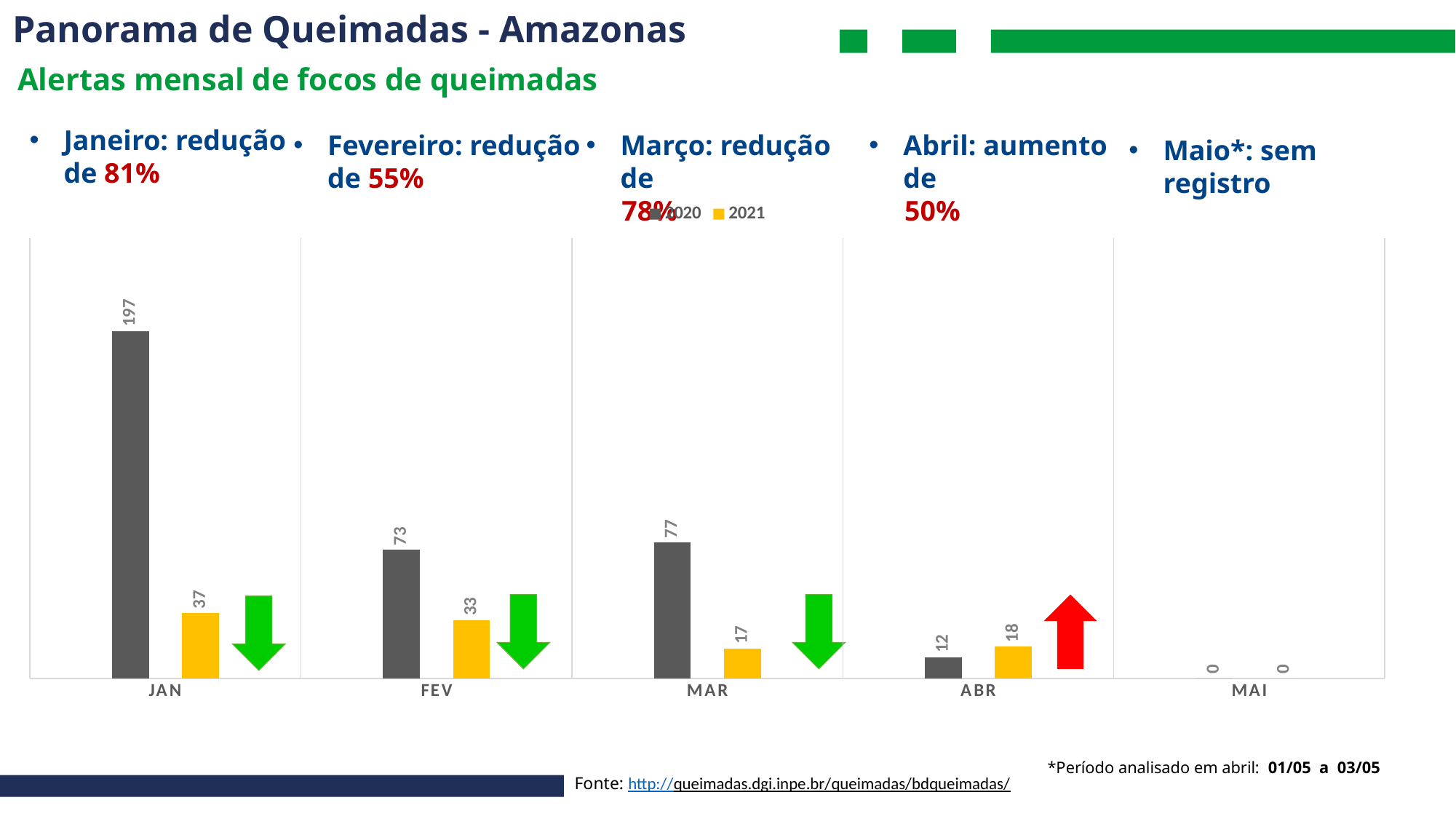
How many series does the legend list? 2 What kind of chart is shown on the slide? Bar chart What is the value for 2020 in ABR? 12 What is the value for 2020 in JAN? 197 In ABR, which series has the larger value, 2020 or 2021? 2021 Which month has the lowest value for 2021? MAI What is the value for 2021 in FEV? 33 What is the value for 2021 in MAR? 17 How many months are shown on the x axis? 5 What is the difference between the 2020 and 2021 values in MAR? 60 Which month has the highest value for 2020? JAN What is the difference between the 2020 and 2021 values in JAN? 160